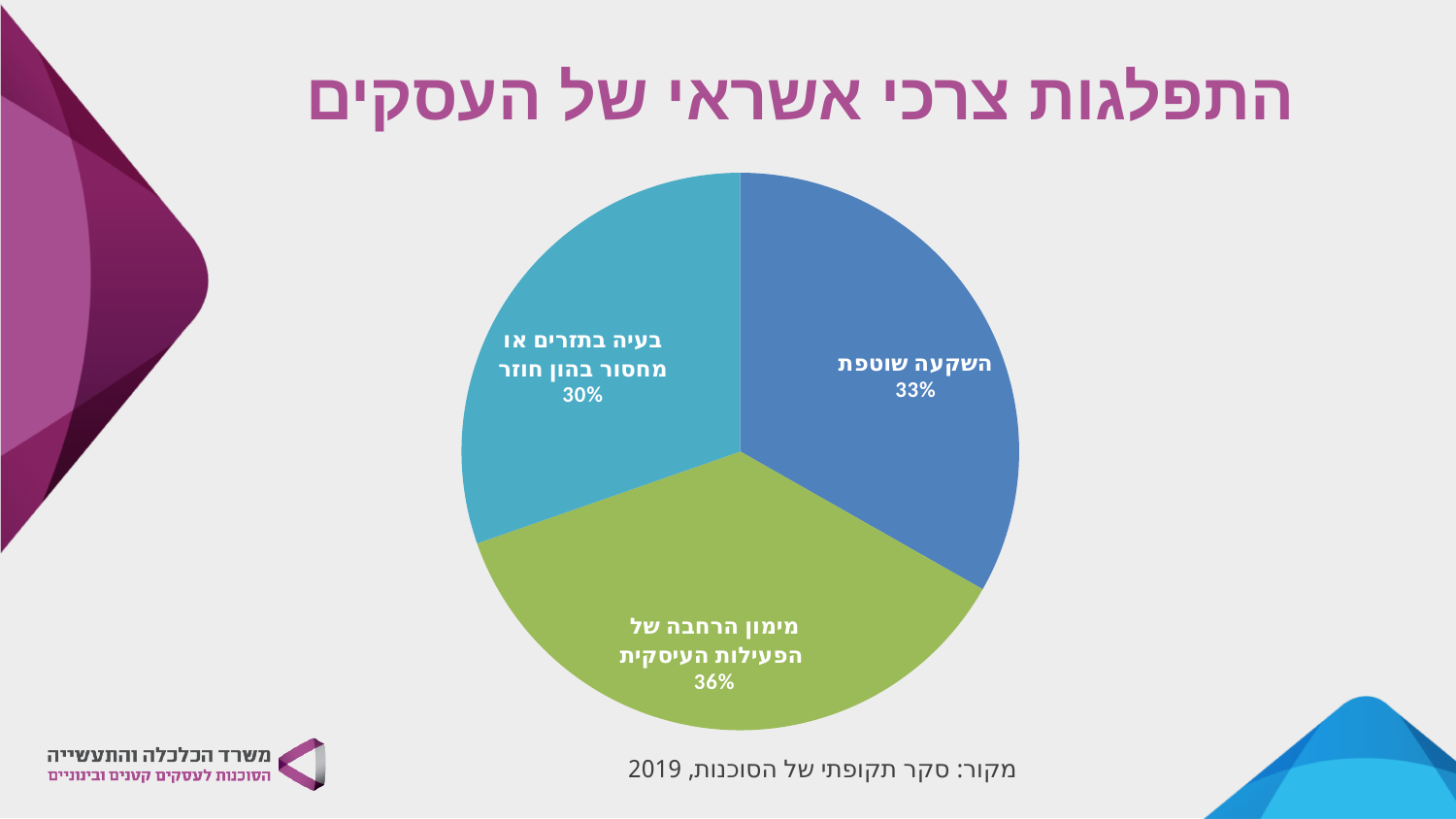
What share of the pie is labelled מימון הרחבה של הפעילות העיסקית? 36% What is the title of the chart on the slide? התפלגות צרכי אשראי של העסקים Which category has the largest share of the pie? מימון הרחבה של הפעילות העיסקית What type of chart is shown on the slide? pie chart What share of the pie is labelled בעיה בתזרים או מחסור בהון חוזר? 30% What is the difference in percentage points between מימון הרחבה של הפעילות העיסקית and בעיה בתזרים או מחסור בהון חוזר? 6 What is the difference in percentage points between השקעה שוטפת and מימון הרחבה של הפעילות העיסקית? 3 Which is larger: the share for השקעה שוטפת or the share for בעיה בתזרים או מחסור בהון חוזר? השקעה שוטפת How many slices does the pie chart have? 3 Which category has the smallest share of the pie? בעיה בתזרים או מחסור בהון חוזר What colour is the slice for מימון הרחבה של הפעילות העיסקית? green What share of the pie is labelled השקעה שוטפת? 33%